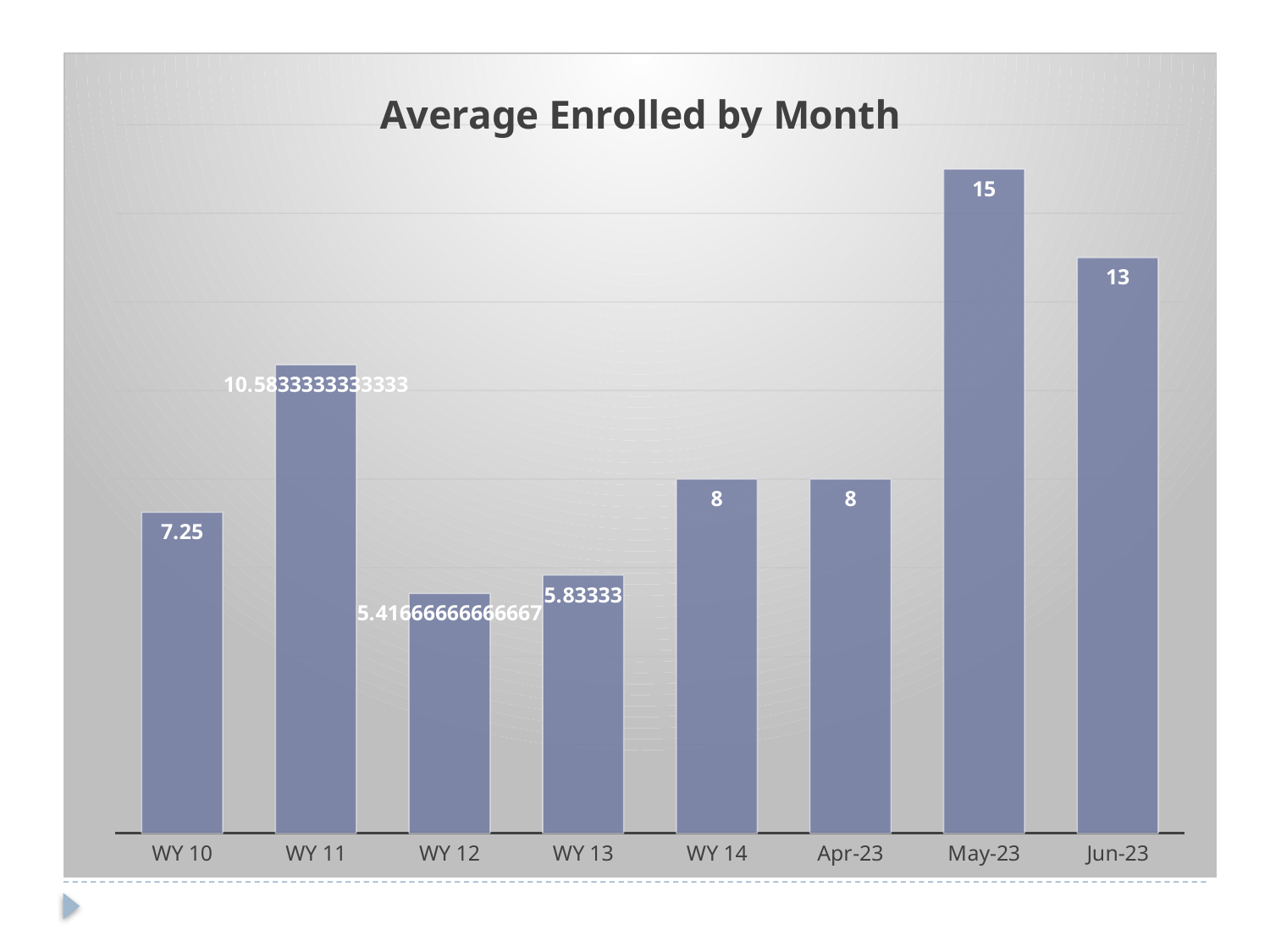
What is the value for May-23? 15 How many categories are shown on the x axis? 8 What is the value for WY 10? 7.25 What is the value for WY 13? 5.83333 Which is larger, the value for WY 10 or the value for WY 14? WY 14 Which category has the lowest value? WY 12 What is the title of the chart? Average Enrolled by Month What kind of chart is this? bar chart What is the difference between the values for May-23 and Jun-23? 2 What is the value for WY 12? 5.41666666666667 What is the value for WY 11? 10.5833333333333 Which category has the highest value? May-23